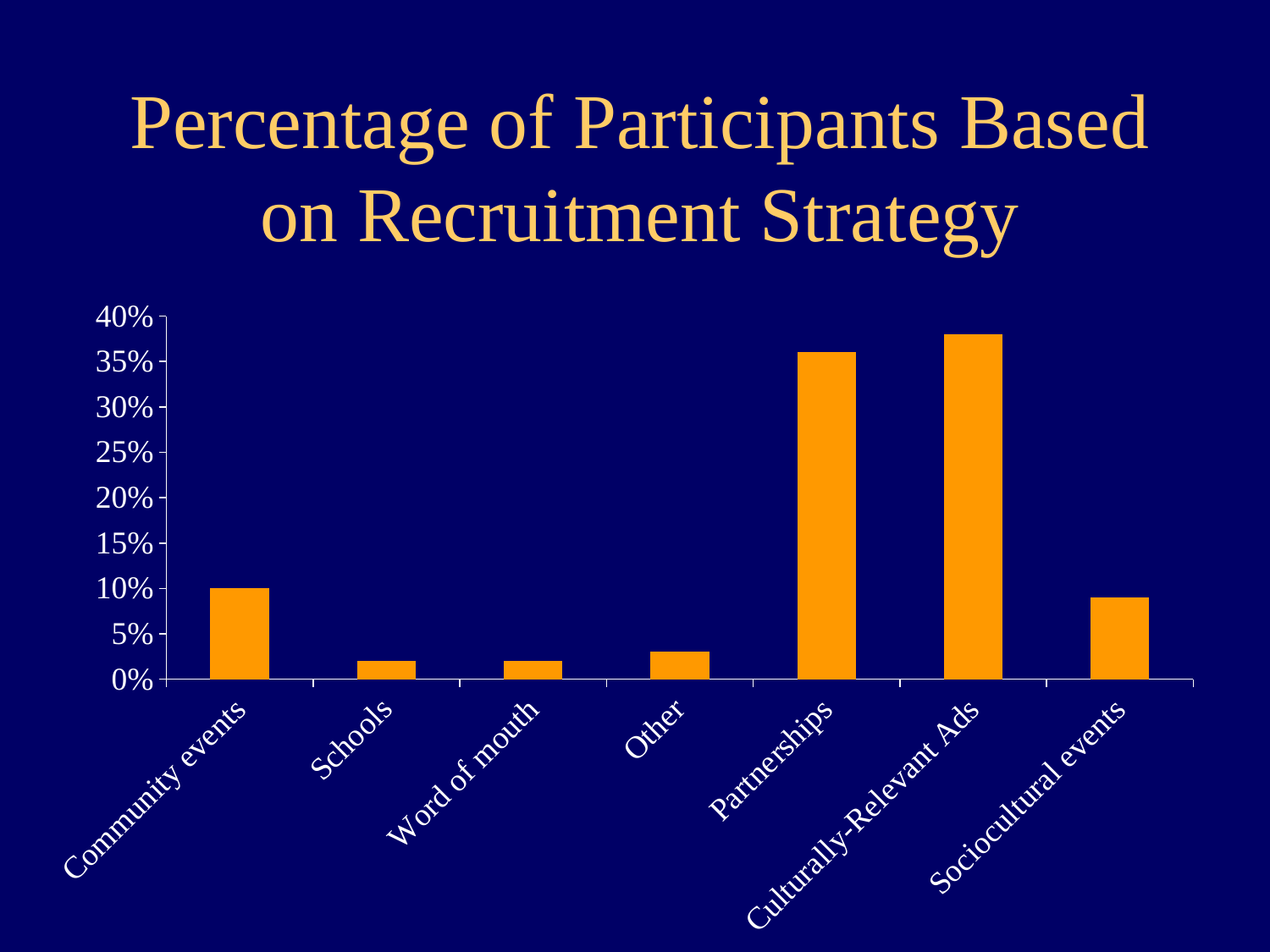
What kind of chart is shown on the slide? Bar chart Which is larger, the value for Partnerships or the value for Sociocultural events? Partnerships Which recruitment strategy has the highest percentage of participants? Culturally-Relevant Ads Is the value for Other greater or less than 5%? less Is the value for Partnerships greater or less than 35%? greater What is the title of the chart? Percentage of Participants Based on Recruitment Strategy How many recruitment strategy categories are shown on the x axis? 7 Which is larger, the value for Community events or the value for Word of mouth? Community events Is the value for Schools greater or less than 5%? less What is the percentage of participants for Community events? 10%